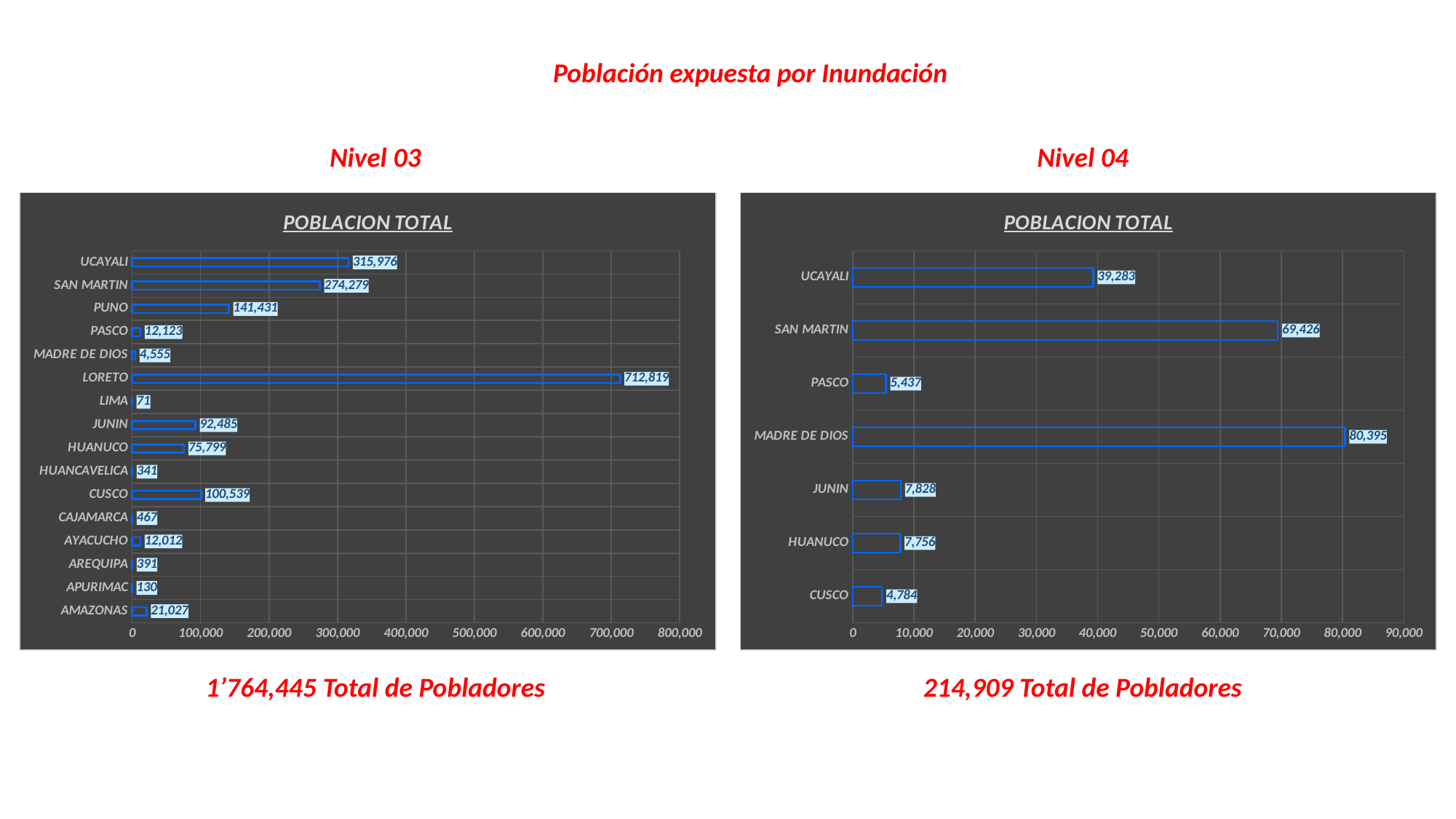
In the Nivel 04 chart on the right, which category has the highest value? MADRE DE DIOS In the Nivel 03 chart on the left, what is the difference between UCAYALI and SAN MARTIN? 41,697 In the Nivel 03 chart on the left, which category has the lowest value? LIMA How many categories are shown in the Nivel 04 chart on the right? 7 What kind of chart is the Nivel 03 chart on the left? Bar chart In the Nivel 03 chart on the left, what is the value for LORETO? 712,819 How many categories are shown in the Nivel 03 chart on the left? 16 In the Nivel 04 chart on the right, what is the difference between MADRE DE DIOS and SAN MARTIN? 10,969 In the Nivel 04 chart on the right, what is the value for UCAYALI? 39,283 In the Nivel 04 chart on the right, which category has the lowest value? CUSCO In the Nivel 03 chart on the left, which is larger, PUNO or CUSCO? PUNO In the Nivel 03 chart on the left, which category has the highest value? LORETO